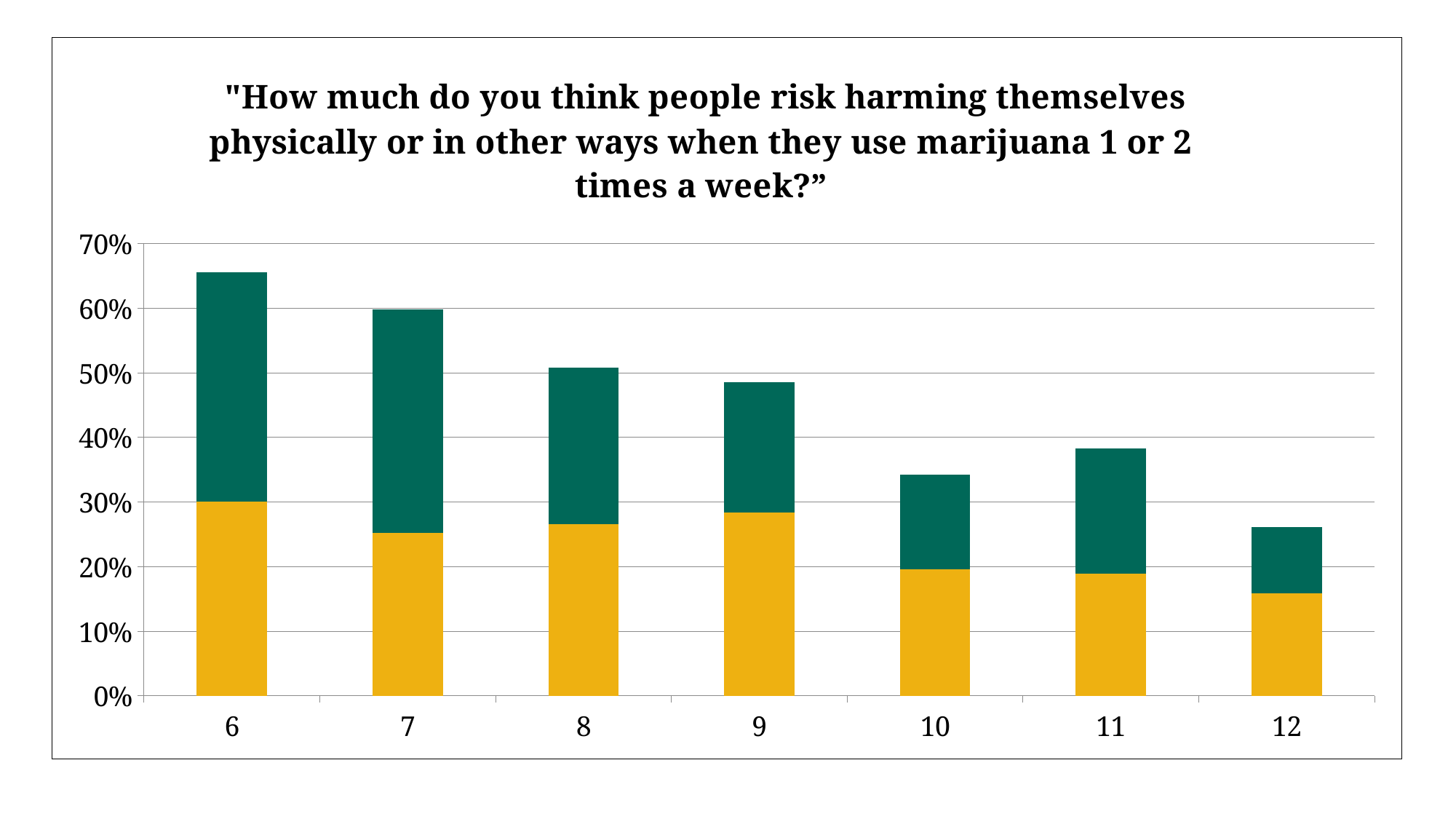
What kind of chart is shown on the slide? Stacked bar chart Is the total height of the bar for category 6 greater or less than 60%? greater Do the total bar heights generally rise or fall from category 6 to category 12? fall Which has the taller stacked bar overall, category 10 or category 11? 11 Which category has the shortest stacked bar overall? 12 Is the total height of the bar for category 12 greater or less than 30%? less Is the yellow segment for category 7 greater or less than 20%? greater Which category has the tallest stacked bar overall? 6 What two colours are used for the segments of the stacked bars? Yellow and green How many categories are shown along the x axis? 7